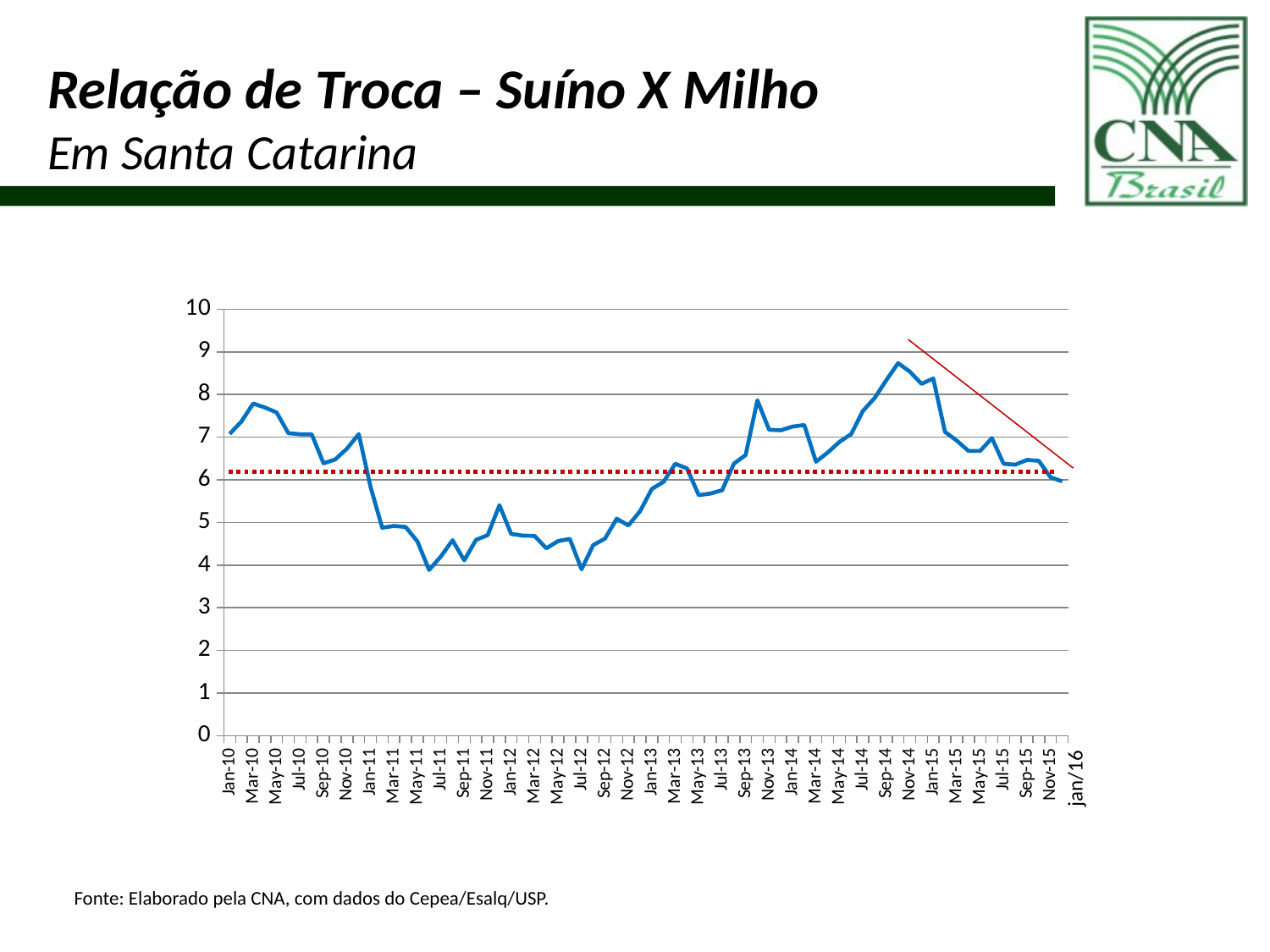
Which month shows the highest value on the line? Oct-14 Is the value for Jul-12 greater or less than 5? less What kind of chart is shown on the slide? line chart Is the value for Mar-10 greater or less than 7? greater Is the value for Jul-11 greater or less than 5? less Does the line rise or fall between Nov-14 and Jan-16? fall What is the highest value shown on the vertical axis? 10 Which is larger, the value for Nov-14 or the value for Jul-11? Nov-14 Does the line rise or fall between Jan-11 and Jul-11? fall What is the title of the chart on the slide? Relação de Troca – Suíno X Milho